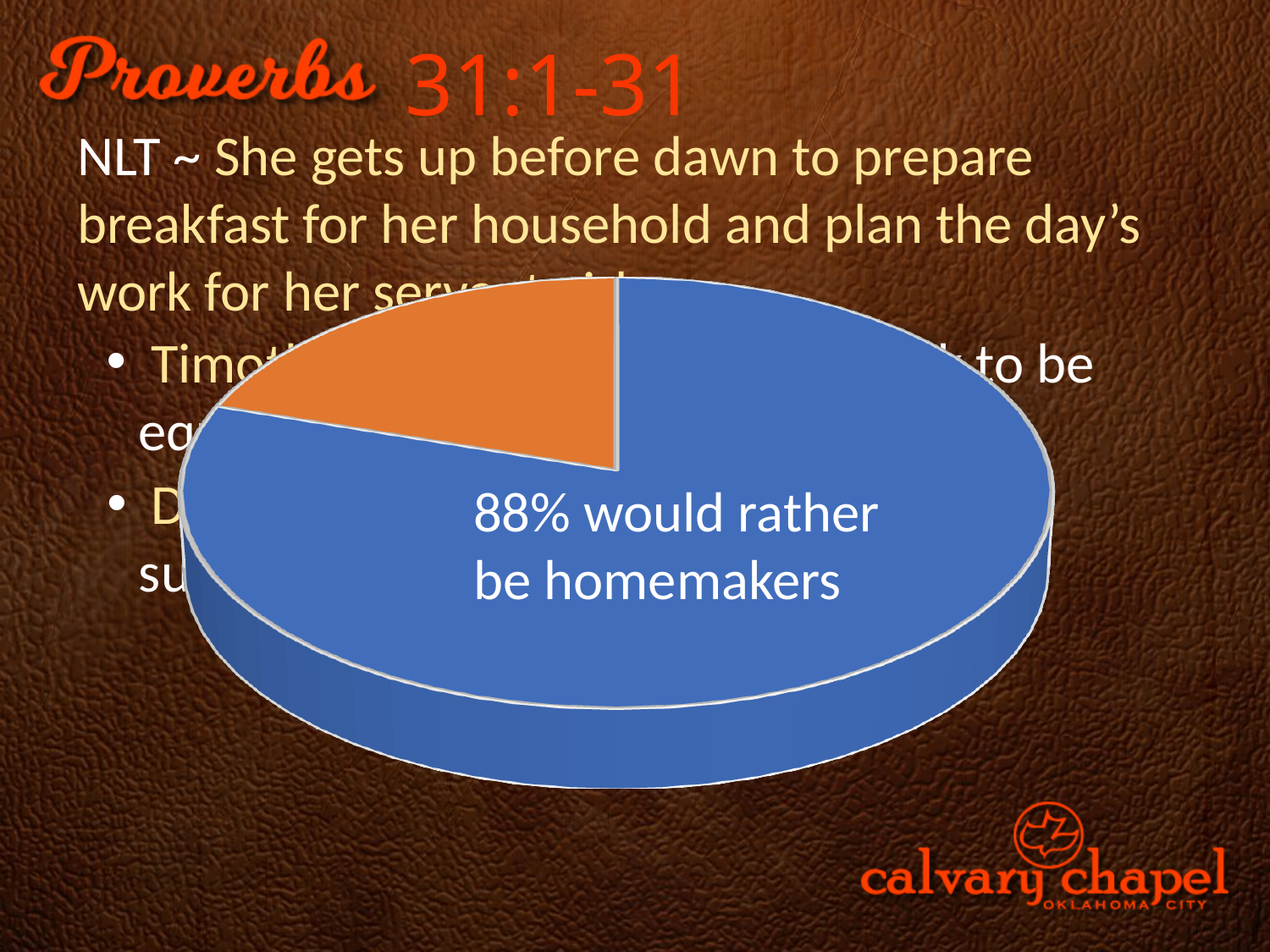
Which slice of the pie chart is the largest? The blue slice (88% would rather be homemakers) Is the orange slice of the pie chart greater or less than 50% of the pie? less What does the text label on the pie chart say? 88% would rather be homemakers Is the blue slice of the pie chart greater or less than 50% of the pie? greater How many slices does the pie chart have? 2 What colour is the slice labelled "88% would rather be homemakers"? Blue What kind of chart is shown on the slide? Pie chart Which slice of the pie chart is the smallest? The orange slice What percentage is printed on the large blue slice of the pie chart? 88% According to the label on the pie chart, what share would rather be homemakers? 88% Which slice of the pie chart is larger, the blue one or the orange one? The blue one